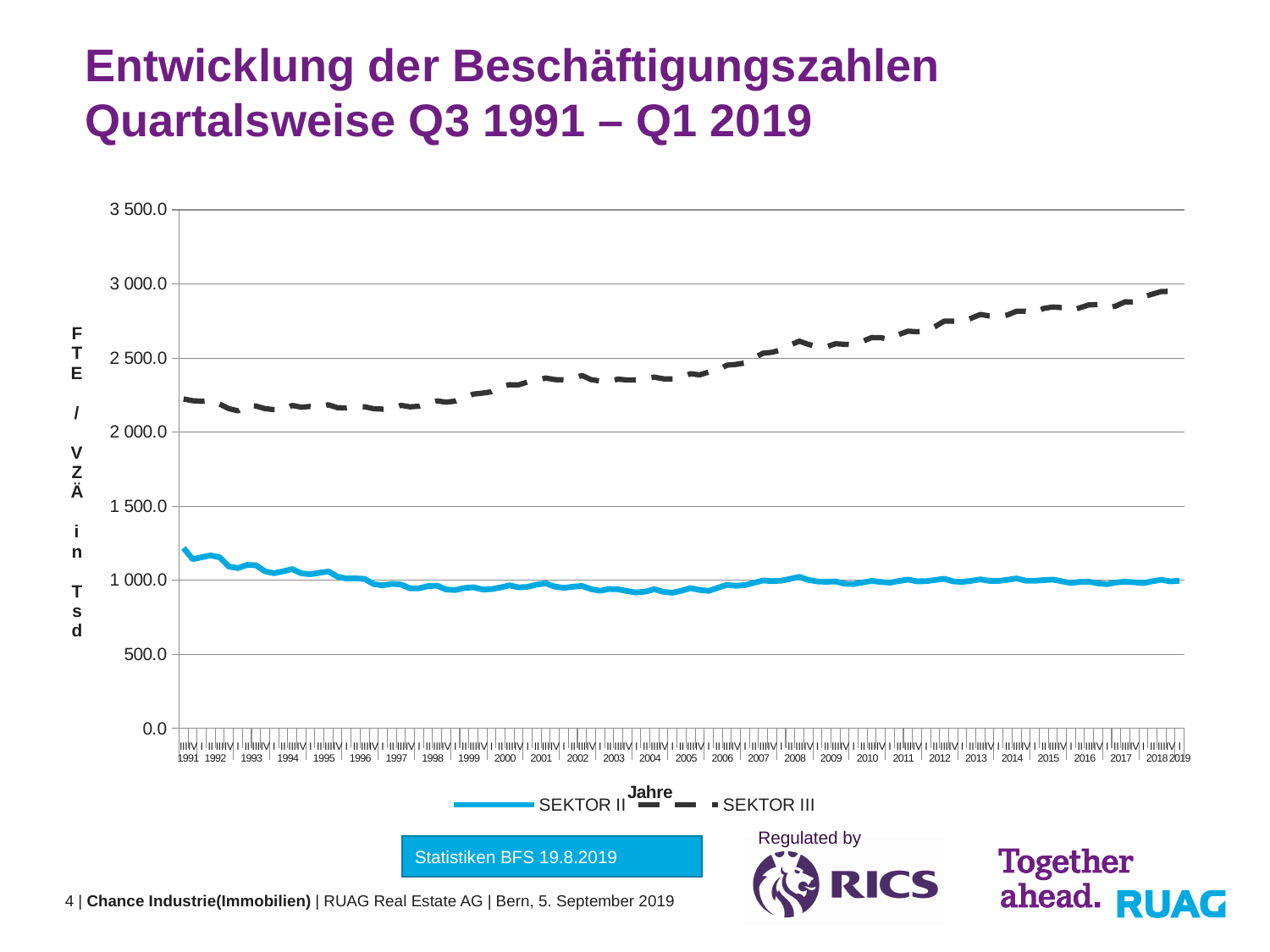
Is the value for SEKTOR III in 1991 greater or less than 2 000.0? greater Is the value for SEKTOR II at the start of the chart in 1991 greater or less than 1 000.0? greater How many series does the legend list? 2 What is the title of the chart? Entwicklung der Beschäftigungszahlen Quartalsweise Q3 1991 – Q1 2019 What kind of chart is shown on the slide? line chart Does the SEKTOR II line rise or fall overall from 1991 to 2019? fall Which two series are listed in the legend? SEKTOR II and SEKTOR III Is the value for SEKTOR III in 2005 greater or less than 2 500.0? less Which series has the higher values throughout the chart, SEKTOR II or SEKTOR III? SEKTOR III Does the SEKTOR III line rise or fall overall from 1991 to 2019? rise